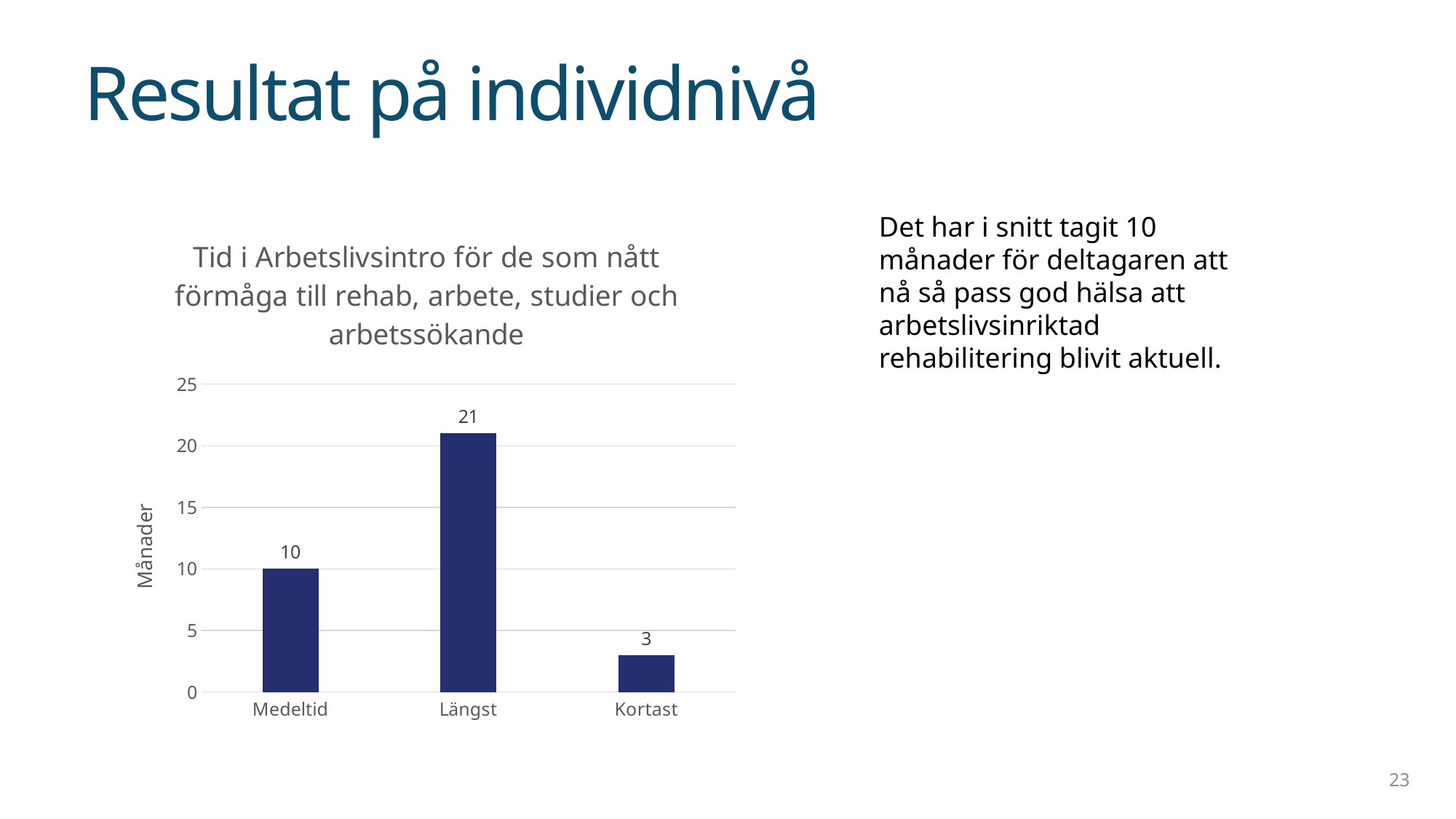
What is the value for Medeltid? 10 Which is larger, the value for Medeltid or the value for Kortast? Medeltid What is the difference between the values for Medeltid and Kortast? 7 Is the value for Längst greater or less than 20? greater What is the label of the vertical axis? Månader Which category has the highest value? Längst What is the value for Kortast? 3 What is the difference between the values for Längst and Medeltid? 11 What is the value for Längst? 21 What kind of chart is shown on the slide? bar chart Which category has the lowest value? Kortast How many categories are shown on the x axis? 3